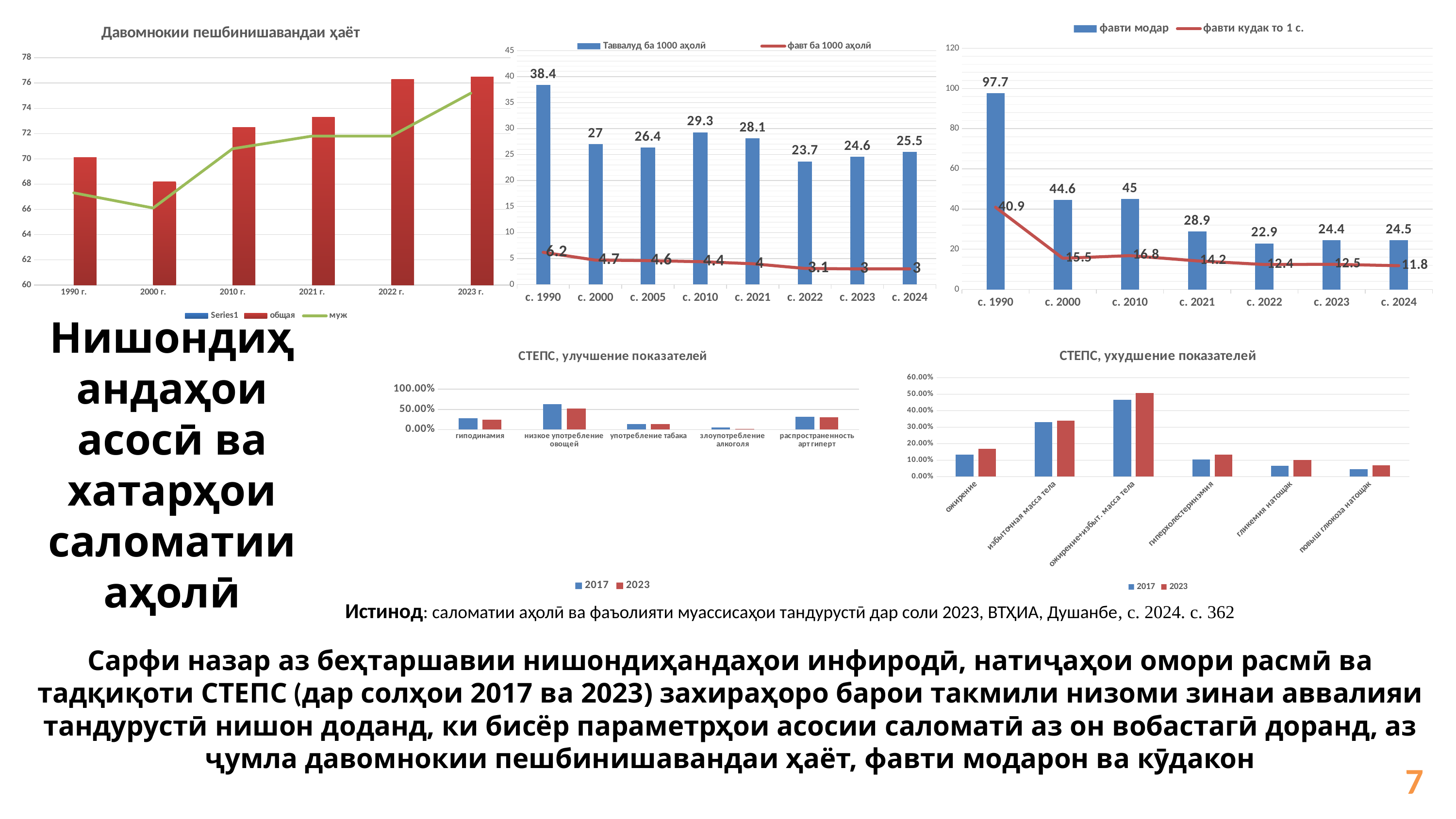
In the chart titled 'Давомнокии пешбинишавандаи ҳаёт', is the bar for 2000 г. greater or less than 70? less In the chart with the legend 'Таввалуд ба 1000 аҳолӣ', which year has the lowest Таввалуд ба 1000 аҳолӣ value? с. 2022 In the chart with the legend 'фавти модар', what is the value of фавти модар for с. 1990? 97.7 In the chart titled 'Давомнокии пешбинишавандаи ҳаёт', is the bar for 2023 г. greater or less than 74? greater In the chart with the legend 'фавти модар', how many years are shown on the x axis? 7 In the chart titled 'СТЕПС, ухудшение показателей', how many series does the legend list? 2 In the chart with the legend 'Таввалуд ба 1000 аҳолӣ', what is the value of Таввалуд ба 1000 аҳолӣ for с. 1990? 38.4 In the chart with the legend 'фавти модар', which is larger: фавти модар for с. 2000 or for с. 2010? с. 2010 In the chart with the legend 'фавти модар', what is the value of фавти кудак то 1 с. for с. 2024? 11.8 In the chart with the legend 'Таввалуд ба 1000 аҳолӣ', what is the value of фавт ба 1000 аҳолӣ for с. 2024? 3 In the chart with the legend 'Таввалуд ба 1000 аҳолӣ', what is the difference between the Таввалуд values for с. 1990 and с. 2000? 11.4 In the chart titled 'СТЕПС, улучшение показателей', which category has the highest bar? низкое употребление овощей